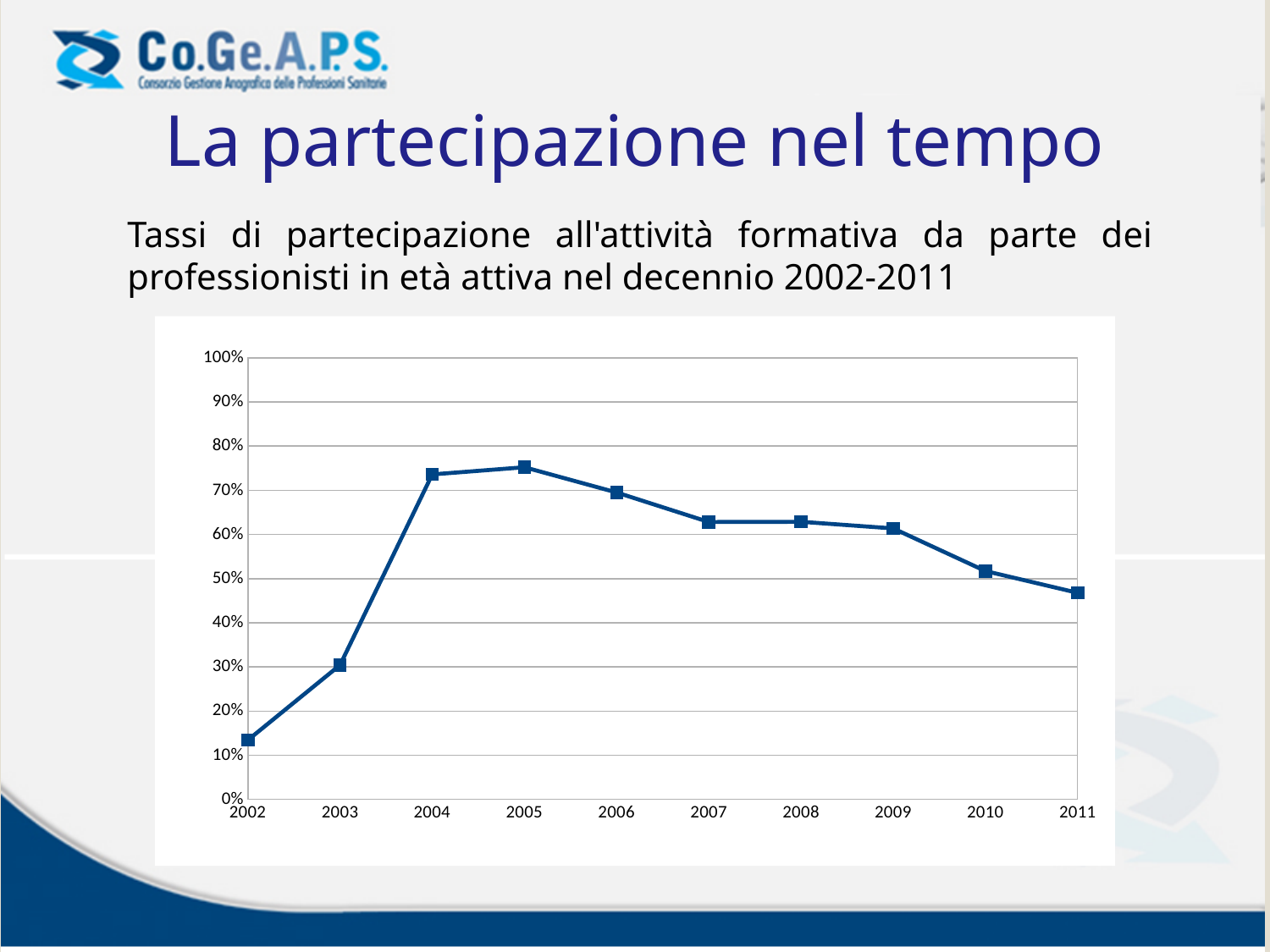
How many years (data points) are plotted on the chart? 10 Which year has the highest participation rate? 2005 Is the value for 2003 greater or less than 20%? greater What is the highest value shown on the vertical axis? 100% What kind of chart is shown on the slide? line chart Is the value for 2011 greater or less than 50%? less Is the value for 2002 greater or less than 20%? less Which year has the lowest participation rate? 2002 Which year has the larger value, 2003 or 2004? 2004 Do the values rise or fall from 2005 to 2011? fall